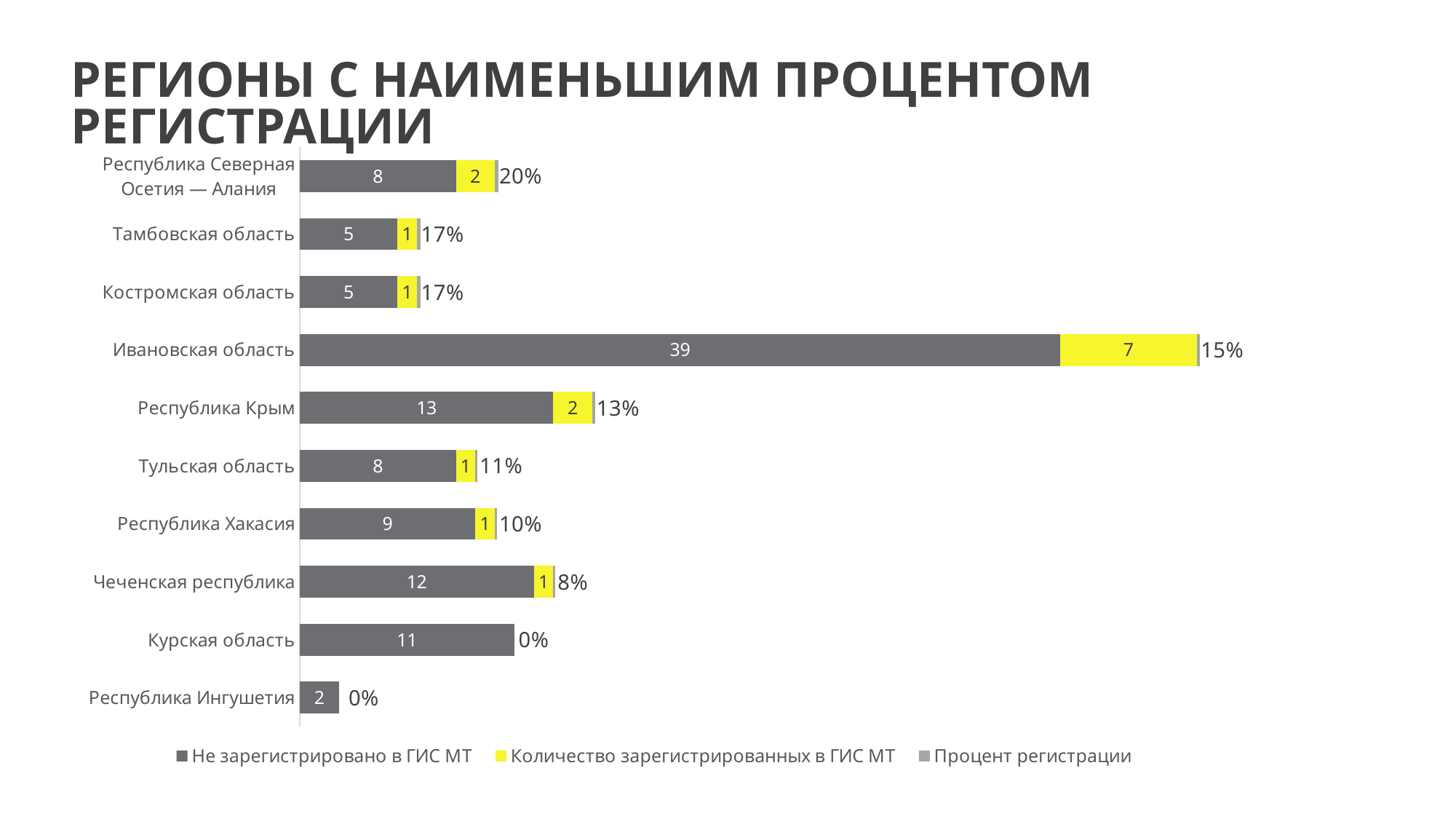
What is the difference between the 'Не зарегистрировано в ГИС МТ' values for Республика Крым and Чеченская республика? 1 What is the value of 'Количество зарегистрированных в ГИС МТ' for Республика Крым? 2 What is the 'Процент регистрации' for Республика Северная Осетия — Алания? 20% What is the total of the stacked bar for Ивановская область (registered plus not registered)? 46 What is the 'Процент регистрации' for Чеченская республика? 8% Which has a larger 'Не зарегистрировано в ГИС МТ' value: Курская область or Республика Хакасия? Курская область Which region has the lowest value of 'Не зарегистрировано в ГИС МТ'? Республика Ингушетия How many regions are shown in the chart? 10 Which region has the highest value of 'Не зарегистрировано в ГИС МТ'? Ивановская область How many series does the legend list? 3 What is the value of 'Не зарегистрировано в ГИС МТ' for Ивановская область? 39 What type of chart is shown on the slide? Stacked bar chart